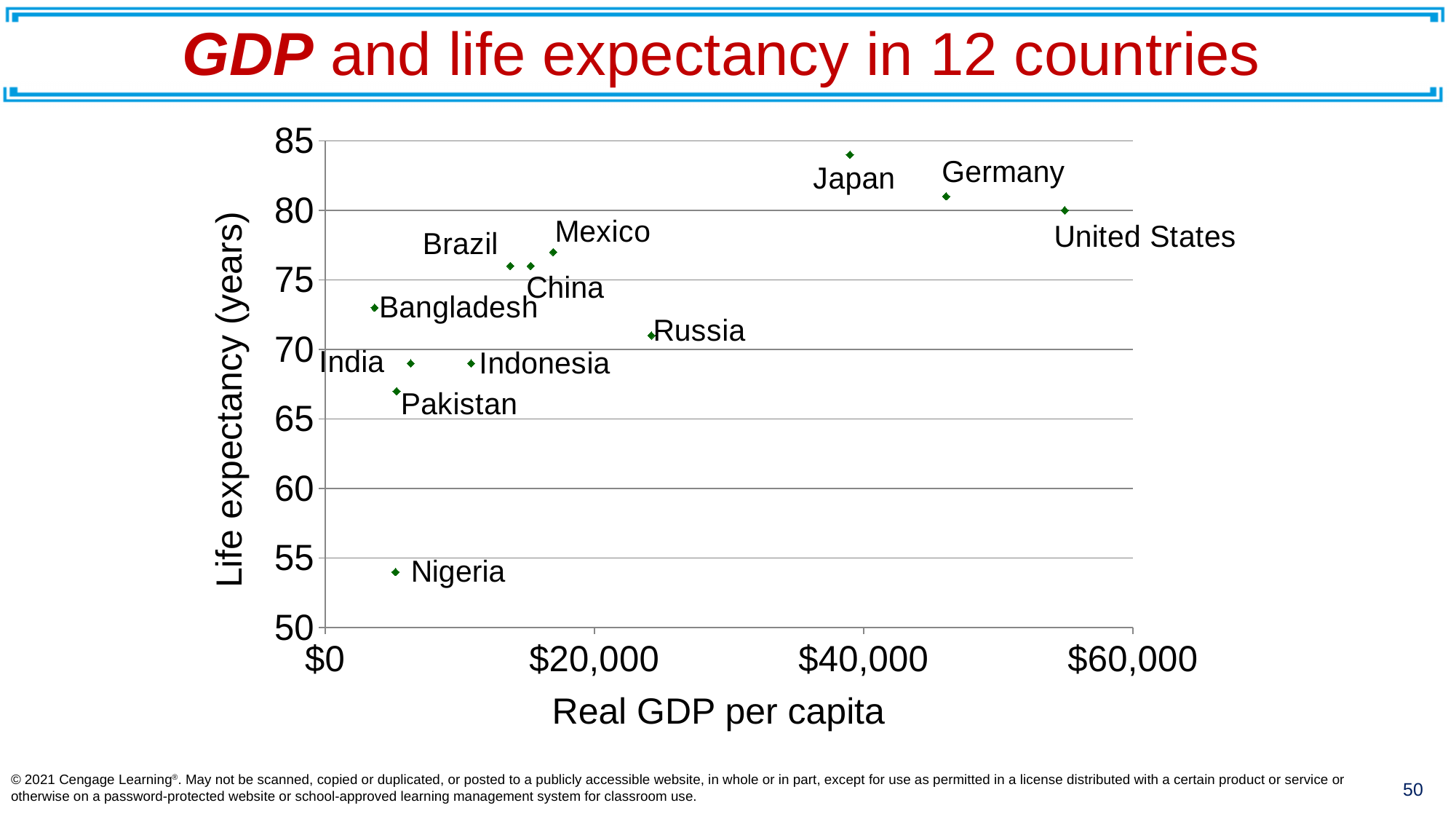
What kind of chart is shown on the slide? scatter chart Which has the higher life expectancy, Japan or Germany? Japan What is the label of the vertical axis? Life expectancy (years) Which country has the highest real GDP per capita on the chart? United States Is the real GDP per capita for Russia greater or less than $20,000? greater Which country has the highest life expectancy on the chart? Japan Is the life expectancy for Nigeria greater or less than 60? less Which has the higher life expectancy, Pakistan or Nigeria? Pakistan Is the real GDP per capita for the United States greater or less than $40,000? greater Which country has the lowest life expectancy on the chart? Nigeria How many countries are plotted on the chart? 12